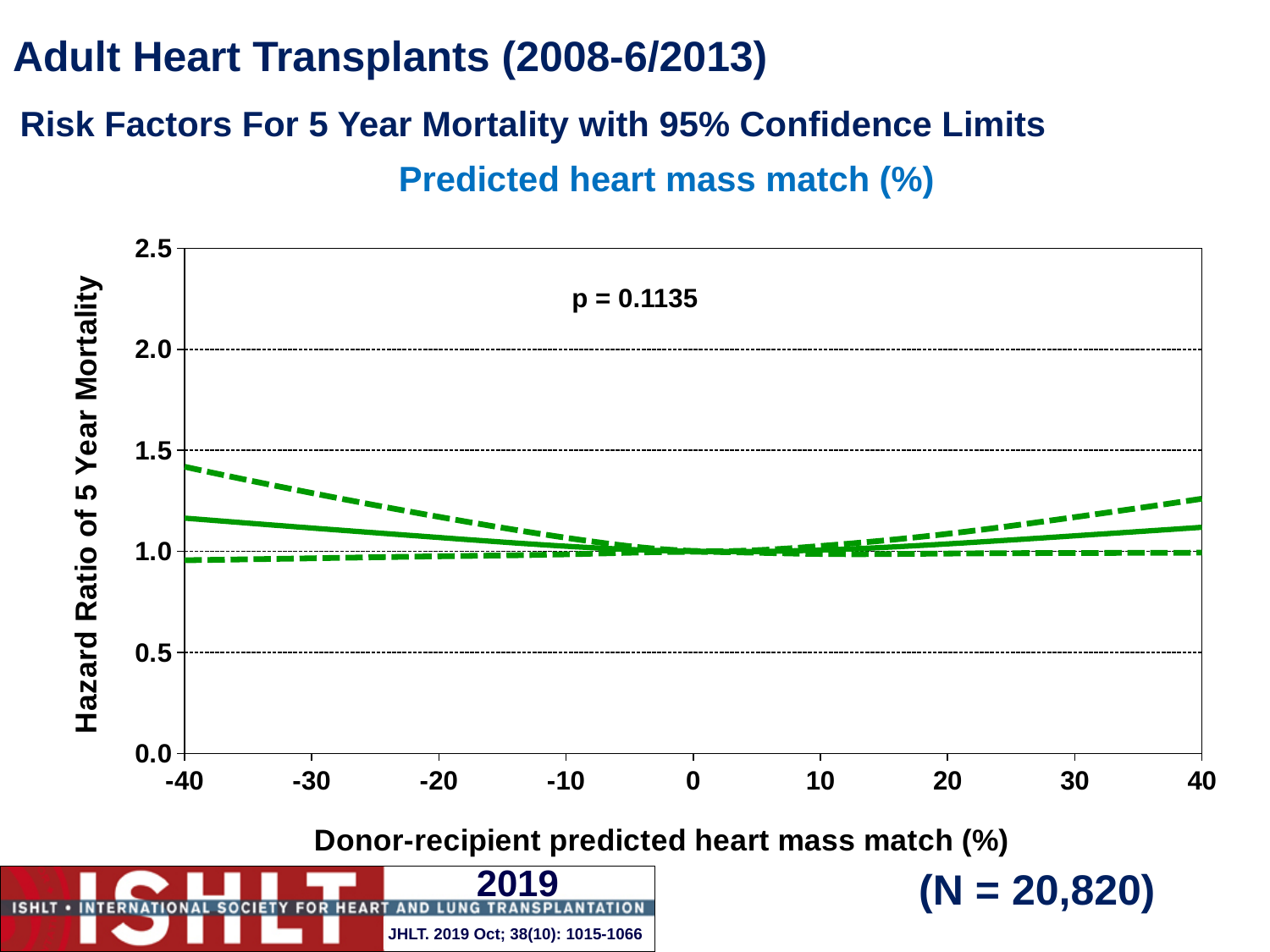
Is the upper dashed confidence limit at a donor-recipient predicted heart mass match of -40% greater or less than 1.0? greater Is the value of the solid hazard ratio line at a donor-recipient predicted heart mass match of -40% greater or less than 1.0? greater Does the solid hazard ratio line rise or fall as the predicted heart mass match goes from 0% to 40%? rise What p-value is printed on the chart? p = 0.1135 What kind of chart is shown on the slide? line chart What sample size (N) is shown on the slide? N = 20,820 How many tick labels are shown on the x axis? 9 Is the value of the solid hazard ratio line at a donor-recipient predicted heart mass match of 40% greater or less than 1.0? greater How many lines are plotted on the chart? 3 Does the solid hazard ratio line rise or fall as the predicted heart mass match goes from -40% to 0%? fall